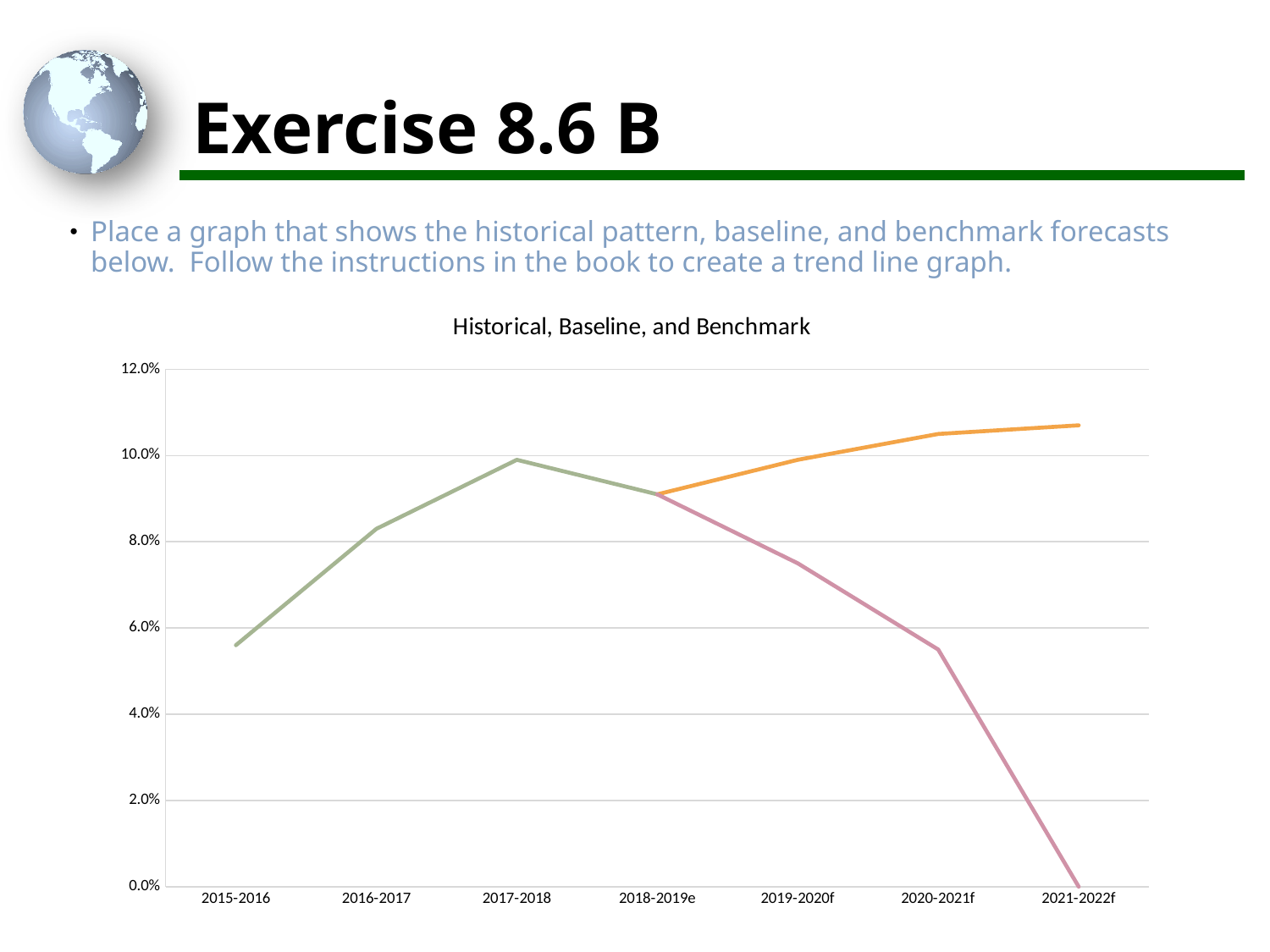
Does the pink line rise or fall from 2018-2019e to 2021-2022f? fall How many lines are plotted on the chart? 3 Does the green line rise or fall from 2015-2016 to 2017-2018? rise Does the orange line rise or fall from 2018-2019e to 2021-2022f? rise What kind of chart is shown on the slide? line chart How many categories are shown on the x axis of the chart? 7 Is the value of the pink line at 2020-2021f greater or less than 6.0%? less What is the title of the chart? Historical, Baseline, and Benchmark Is the value for 2015-2016 greater or less than 6.0%? less At 2021-2022f, which line has the higher value, the orange line or the pink line? the orange line Is the value for 2017-2018 greater or less than 8.0%? greater